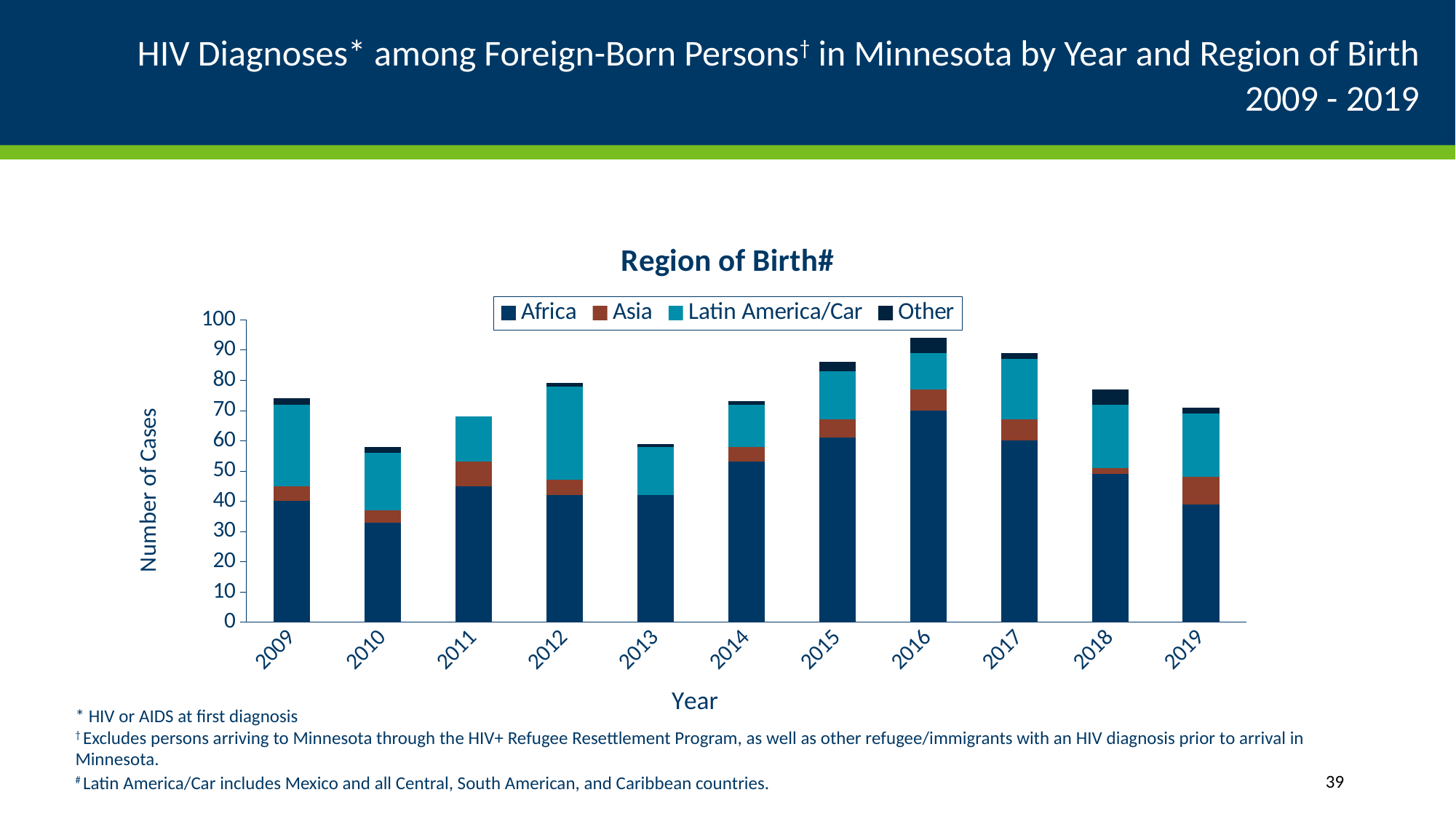
Which year has the smallest Africa segment? 2010 How many series does the legend list? 4 How many years are shown on the x axis? 11 Is the total number of cases for 2010 greater or less than 60? less What kind of chart is shown on the slide? bar chart Is the total number of cases for 2016 greater or less than 90? greater Which year has the highest total number of cases? 2016 Do the total number of cases rise or fall from 2016 to 2019? fall Which year has a larger total number of cases, 2012 or 2013? 2012 What is the title of the y axis? Number of Cases Is the Africa value for 2016 greater or less than 60? greater Which year has the largest Africa segment? 2016